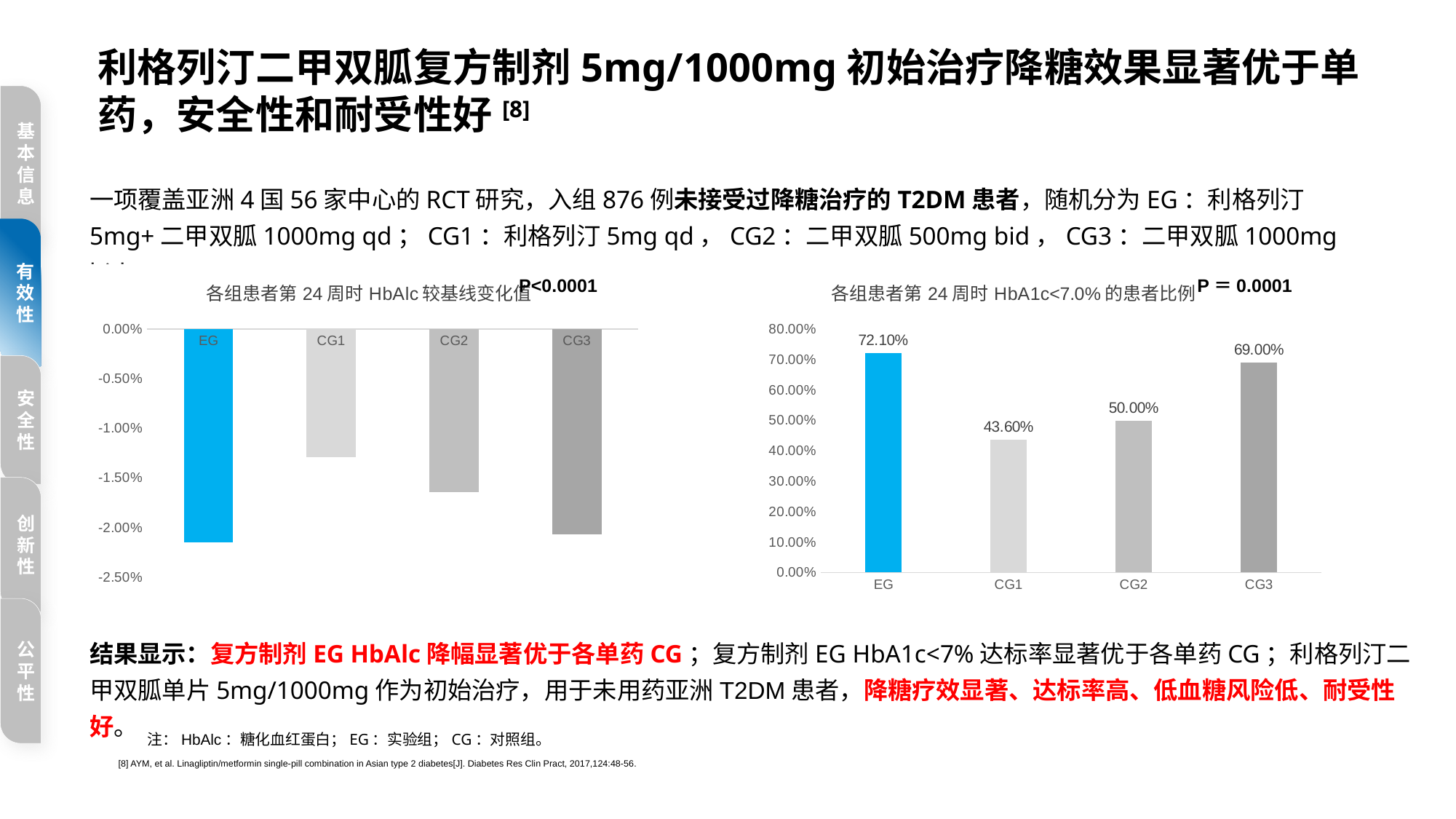
In the right chart (各组患者第 24 周时 HbA1c<7.0% 的患者比例), what is the difference between the values for EG and CG2? 22.10% In the right chart (各组患者第 24 周时 HbA1c<7.0% 的患者比例), what is the value for EG? 72.10% In the left chart (各组患者第 24 周时 HbAlc 较基线变化值), is the value for CG1 greater or less than -1.00%? less In the right chart (各组患者第 24 周时 HbA1c<7.0% 的患者比例), which group has the lowest value? CG1 In the right chart (各组患者第 24 周时 HbA1c<7.0% 的患者比例), what is the value for CG1? 43.60% In the left chart (各组患者第 24 周时 HbAlc 较基线变化值), which group shows the smallest reduction from baseline? CG1 In the right chart (各组患者第 24 周时 HbA1c<7.0% 的患者比例), what is the value for CG3? 69.00% In the right chart (各组患者第 24 周时 HbA1c<7.0% 的患者比例), how many groups are shown? 4 In the right chart (各组患者第 24 周时 HbA1c<7.0% 的患者比例), which group has the highest value? EG What kind of chart is the left chart (各组患者第 24 周时 HbAlc 较基线变化值)? bar chart In the left chart (各组患者第 24 周时 HbAlc 较基线变化值), is the value for EG greater or less than -2.00%? less In the right chart (各组患者第 24 周时 HbA1c<7.0% 的患者比例), which is larger, the value for CG2 or CG3? CG3